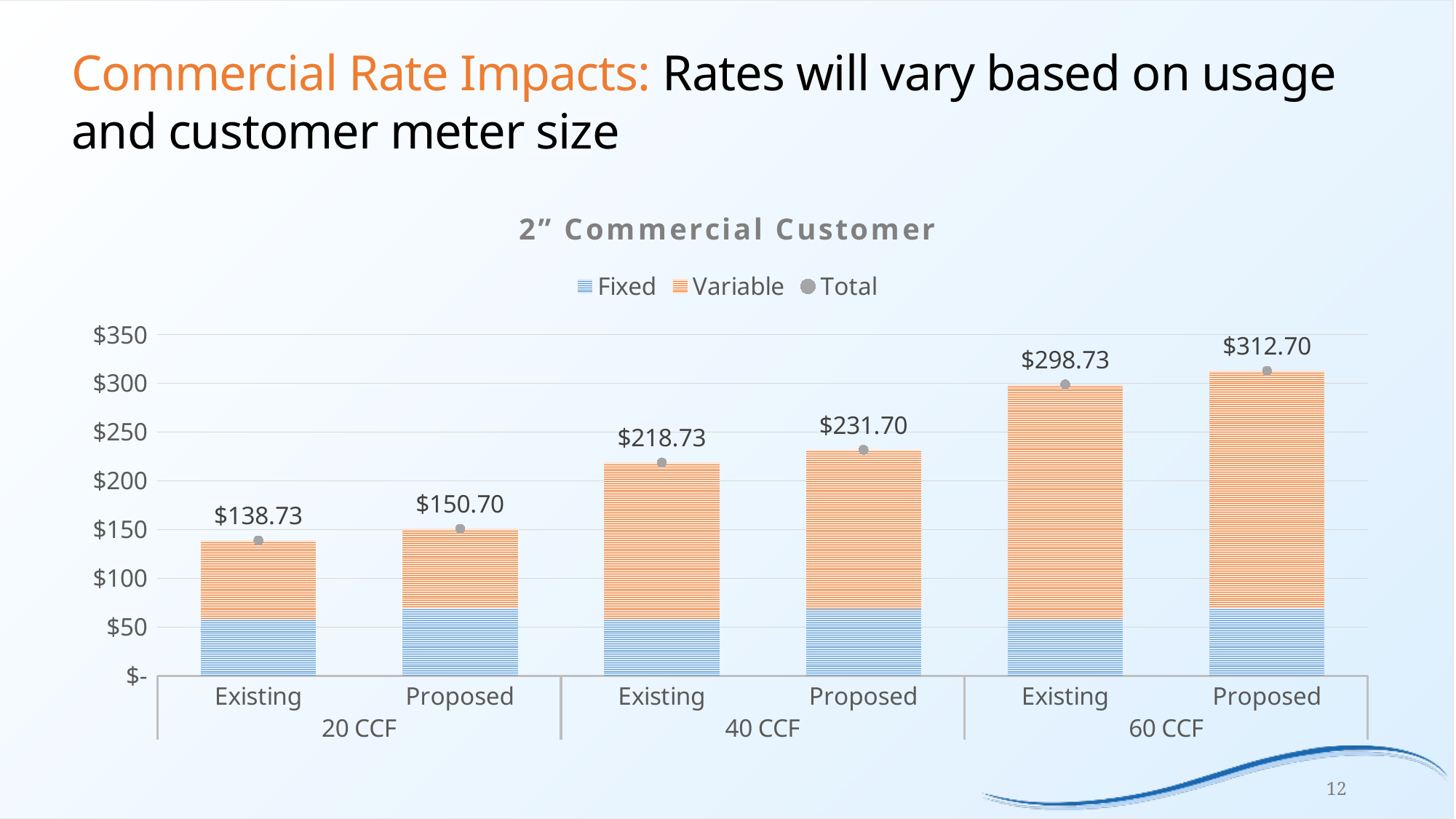
What kind of chart is shown on the slide? Stacked bar chart Is the Fixed portion of the Existing bar at 20 CCF greater or less than $100? less Which bar has the lowest Total? Existing, 20 CCF What is the Total for the Proposed rate at 40 CCF? $231.70 What is the Total for the Proposed rate at 60 CCF? $312.70 How many bars are plotted in the chart? 6 What is the difference between the Existing Totals at 60 CCF and 20 CCF? $160.00 Which bar has the highest Total? Proposed, 60 CCF What is the Total for the Existing rate at 20 CCF? $138.73 What is the difference between the Proposed and Existing Totals at 40 CCF? $12.97 How many series does the legend list? 3 Which is larger, the Existing Total at 40 CCF or the Proposed Total at 20 CCF? Existing Total at 40 CCF